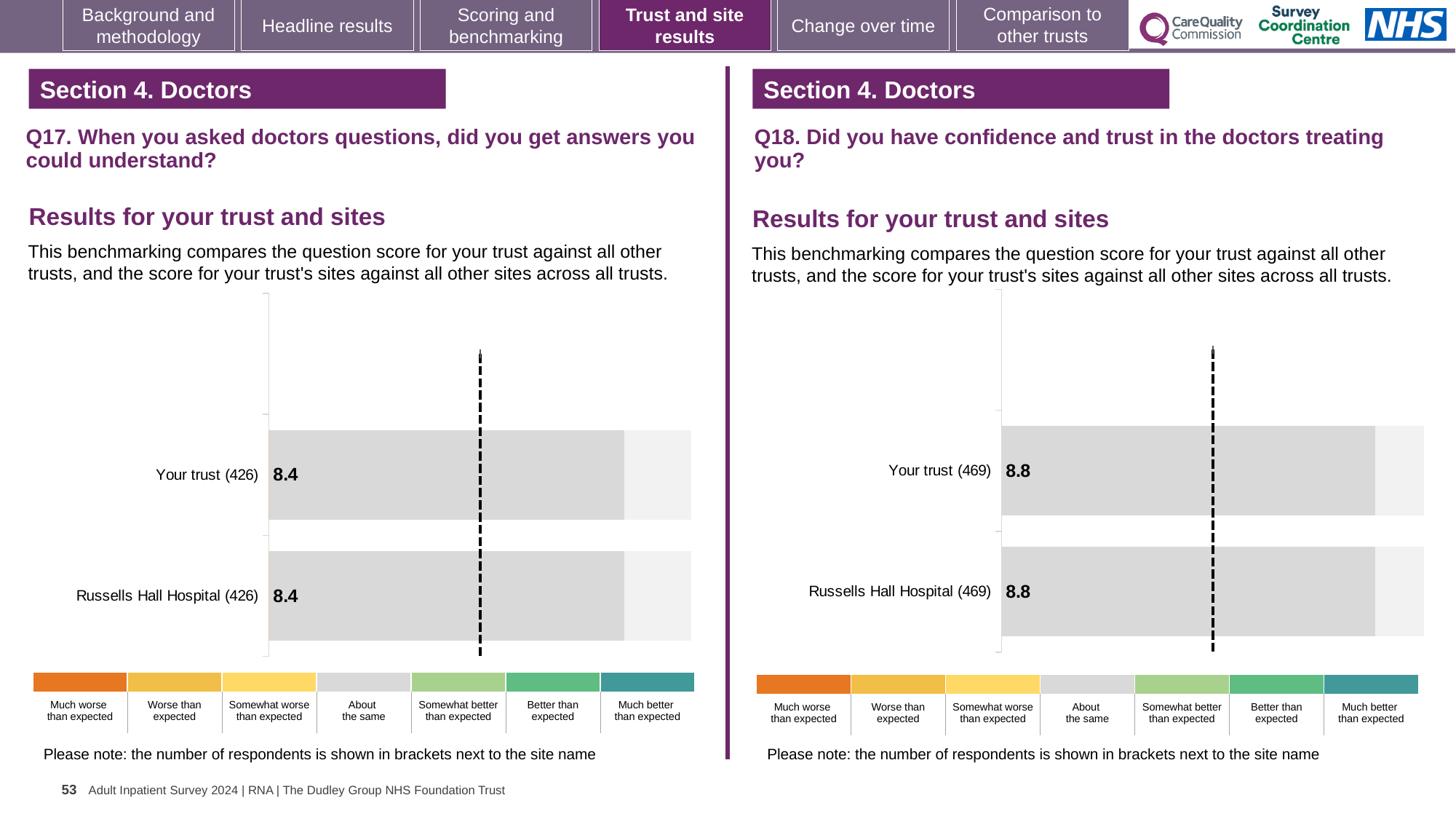
In the Q17 chart on the left, what is the difference between the score for Your trust and the score for Russells Hall Hospital? 0 How many bars are plotted in the Q17 chart on the left? 2 In the Q17 chart on the left, what is the score for Your trust? 8.4 In the Q18 chart on the right, what is the score for Your trust? 8.8 In the Q18 chart on the right, what is the difference between the score for Your trust and the score for Russells Hall Hospital? 0 In the Q17 chart on the left, how many respondents are shown in brackets next to Your trust? 426 In the Q18 chart on the right, what is the score for Russells Hall Hospital? 8.8 What kind of chart is used for the Q18 results on the right? Bar chart In the Q18 chart on the right, how many respondents are shown in brackets next to Russells Hall Hospital? 469 In the Q17 chart on the left, what is the score for Russells Hall Hospital? 8.4 How many bars are plotted in the Q18 chart on the right? 2 Is the score for Your trust in the Q18 chart on the right larger than the score for Your trust in the Q17 chart on the left? Yes